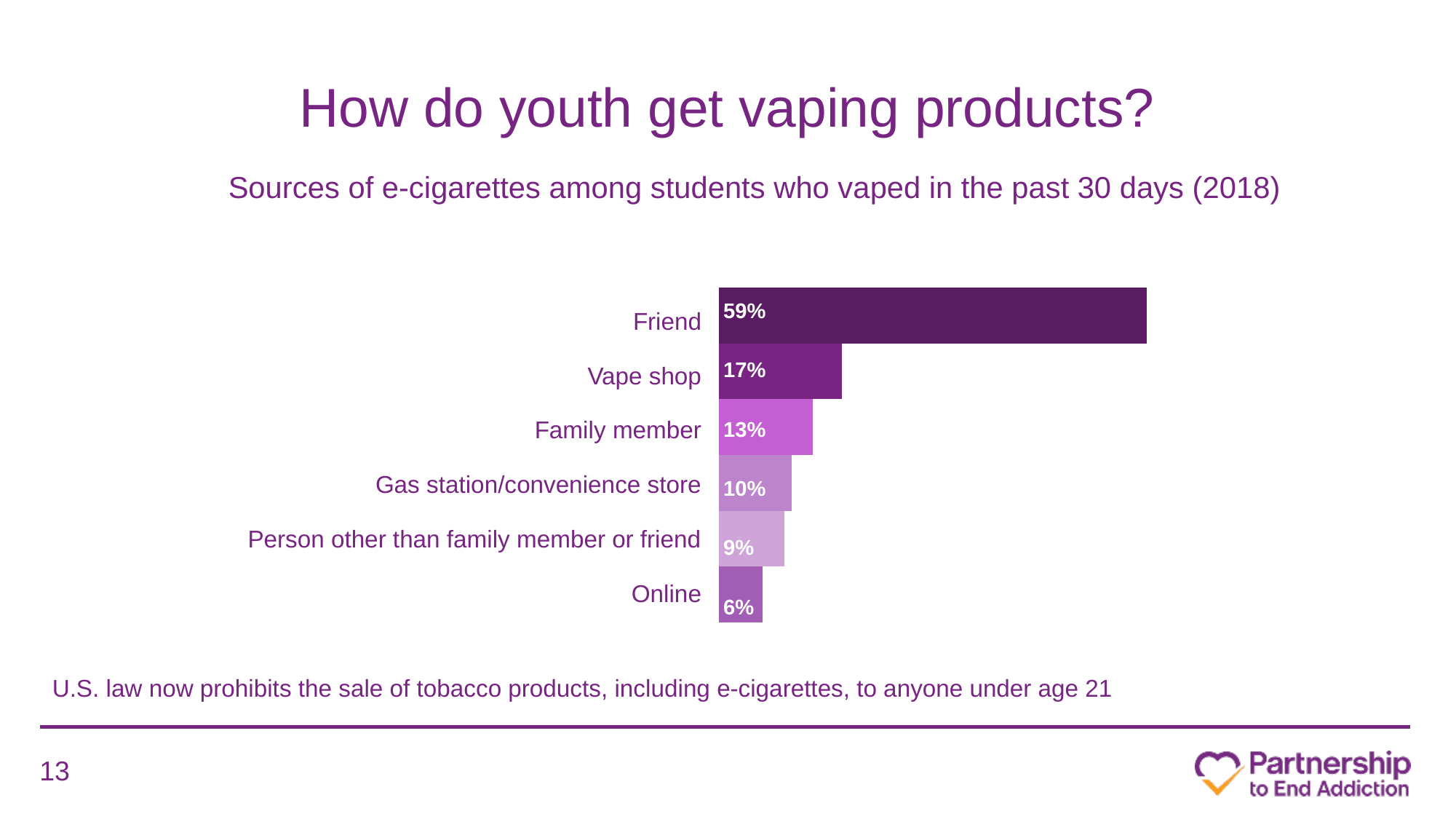
What is the difference between the Friend and Vape shop percentages? 42% What is the subtitle describing the chart's data? Sources of e-cigarettes among students who vaped in the past 30 days (2018) Which is larger, the value for Family member or the value for Person other than family member or friend? Family member What is the value shown for Vape shop? 17% What kind of chart is shown on the slide? Bar chart What is the value shown for Family member? 13% Which source has the lowest percentage? Online What is the value shown for Gas station/convenience store? 10% What percentage of students who vaped in the past 30 days got e-cigarettes from a friend? 59% What is the value shown for Online? 6% How many sources (categories) are shown in the chart? 6 Which source has the highest percentage? Friend